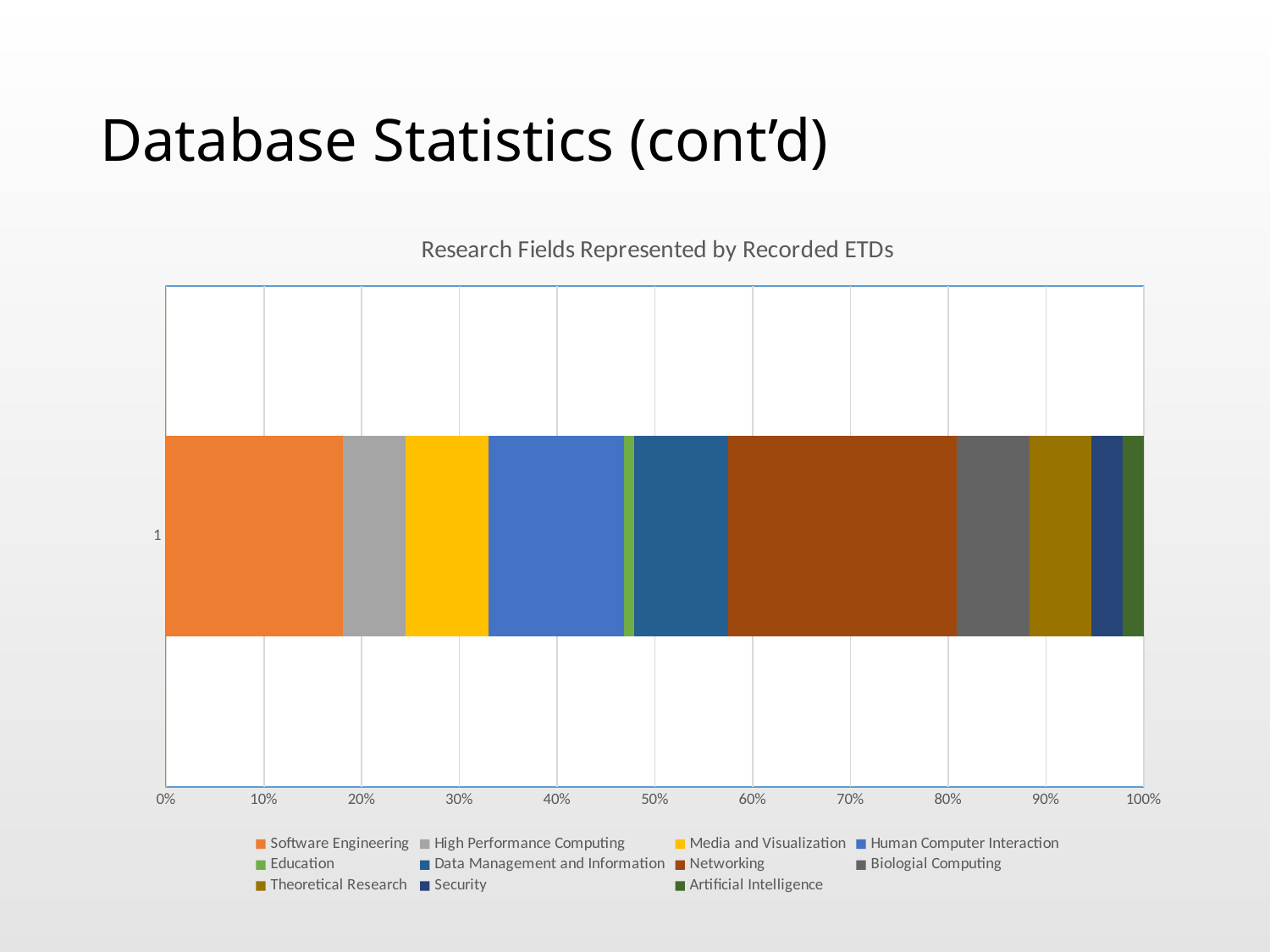
Which research field takes up the largest share of the bar? Networking What kind of chart is shown on the slide? Stacked bar chart What is the label on the vertical axis for the single bar? 1 Which segment is larger, Networking or Human Computer Interaction? Networking Is the share for Networking greater or less than 20%? greater How many bars (categories) are plotted in the chart? 1 How many series does the legend list? 11 Is the share for Software Engineering greater or less than 10%? greater Which research field takes up the smallest share of the bar? Education Is the share for Education greater or less than 10%? less Which segment is larger, Software Engineering or High Performance Computing? Software Engineering What is the title of the chart? Research Fields Represented by Recorded ETDs